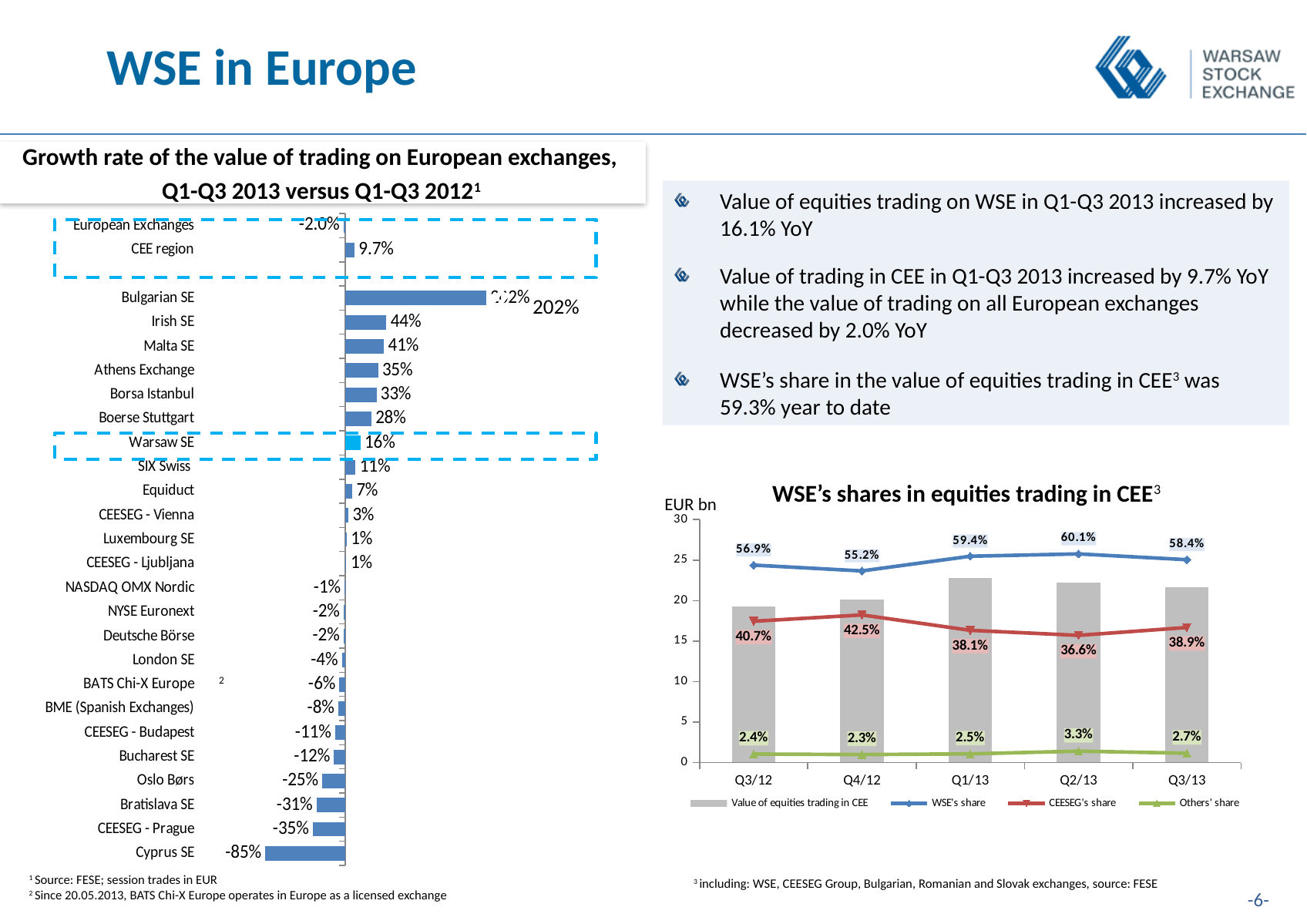
How many series does the legend of the 'WSE's shares in equities trading in CEE' chart list? 4 In the 'Growth rate of the value of trading on European exchanges' chart, what is the value for Cyprus SE? -85% What kind of chart is the 'Growth rate of the value of trading on European exchanges' chart? Bar chart In the 'Growth rate of the value of trading on European exchanges' chart, what is the value for Warsaw SE? 16% In the 'Growth rate of the value of trading on European exchanges' chart, which exchange has the highest growth rate? Bulgarian SE In the 'Growth rate of the value of trading on European exchanges' chart, what is the difference between the values for Irish SE and Malta SE? 3 percentage points In the 'WSE's shares in equities trading in CEE' chart, in which quarter is Others' share highest? Q2/13 In the 'Growth rate of the value of trading on European exchanges' chart, which is larger: the value for Athens Exchange or Borsa Istanbul? Athens Exchange In the 'WSE's shares in equities trading in CEE' chart, what is CEESEG's share in Q4/12? 42.5% In the 'WSE's shares in equities trading in CEE' chart, what is WSE's share in Q2/13? 60.1% In the 'Growth rate of the value of trading on European exchanges' chart, which exchange has the lowest growth rate? Cyprus SE In the 'WSE's shares in equities trading in CEE' chart, is the value of equities trading in CEE in Q1/13 greater or less than 20 EUR bn? greater